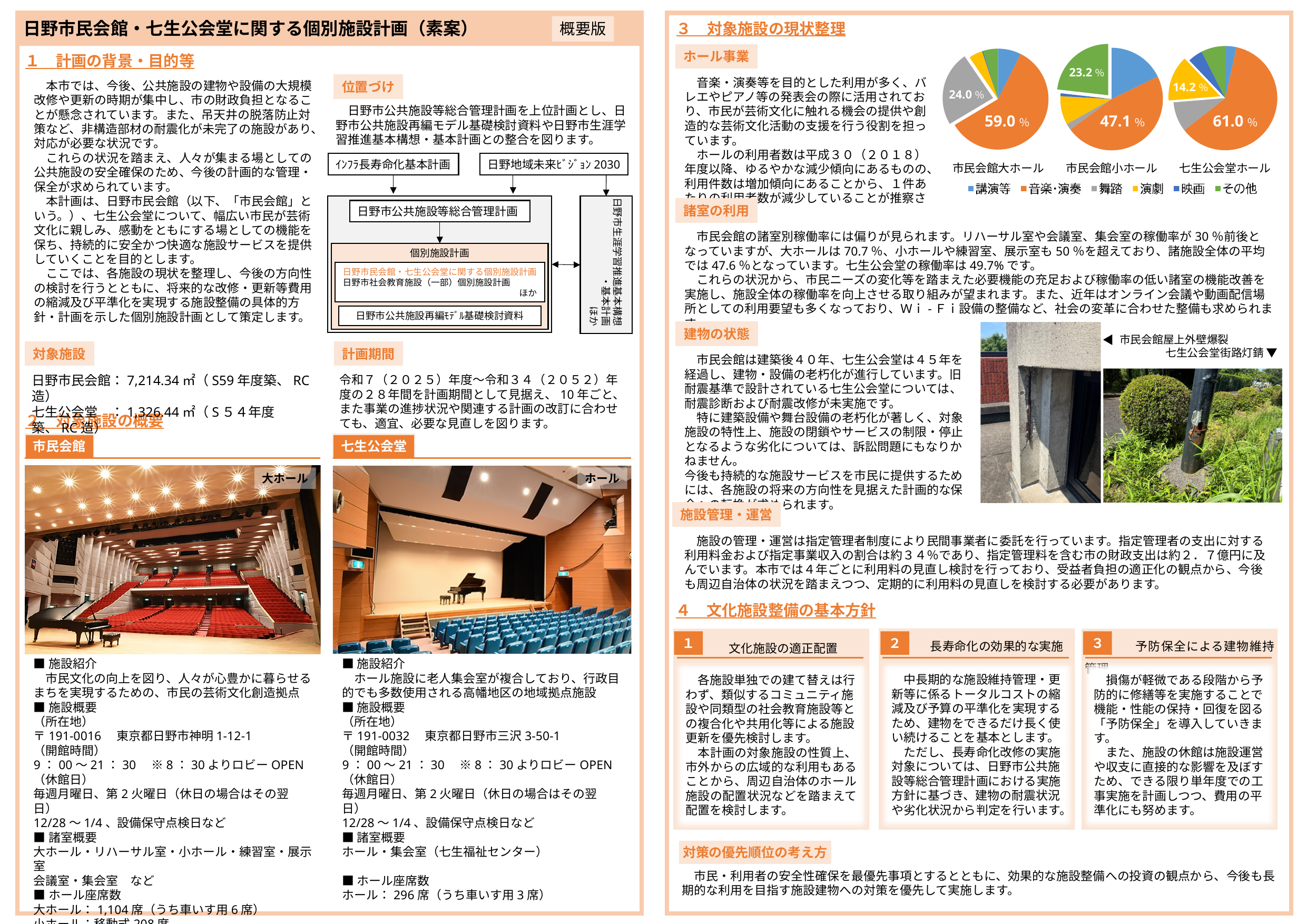
In the 市民会館小ホール pie chart, what share is labelled for the 音楽・演奏 slice? 47.1 % In the 市民会館大ホール pie chart, what share is labelled for the 音楽・演奏 slice? 59.0 % Which hall's pie chart shows the largest share for 音楽・演奏: 市民会館大ホール, 市民会館小ホール or 七生公会堂ホール? 七生公会堂ホール In the 市民会館大ホール pie chart, which category has the largest slice? 音楽・演奏 What type of chart is used to show the hall usage breakdown in the ホール事業 section? Pie chart How many categories does the shared legend of the hall pie charts list? 6 In the 市民会館大ホール pie chart, what share is labelled for the 舞踏 slice? 24.0 % In the 市民会館小ホール pie chart, what share is labelled for the その他 slice? 23.2 % What is the difference between the 音楽・演奏 share in the 七生公会堂ホール chart and the 音楽・演奏 share in the 市民会館小ホール chart? 13.9 % In the hall pie charts, which category is shown in orange according to the legend? 音楽・演奏 In the 七生公会堂ホール pie chart, what share is labelled for the 音楽・演奏 slice? 61.0 %